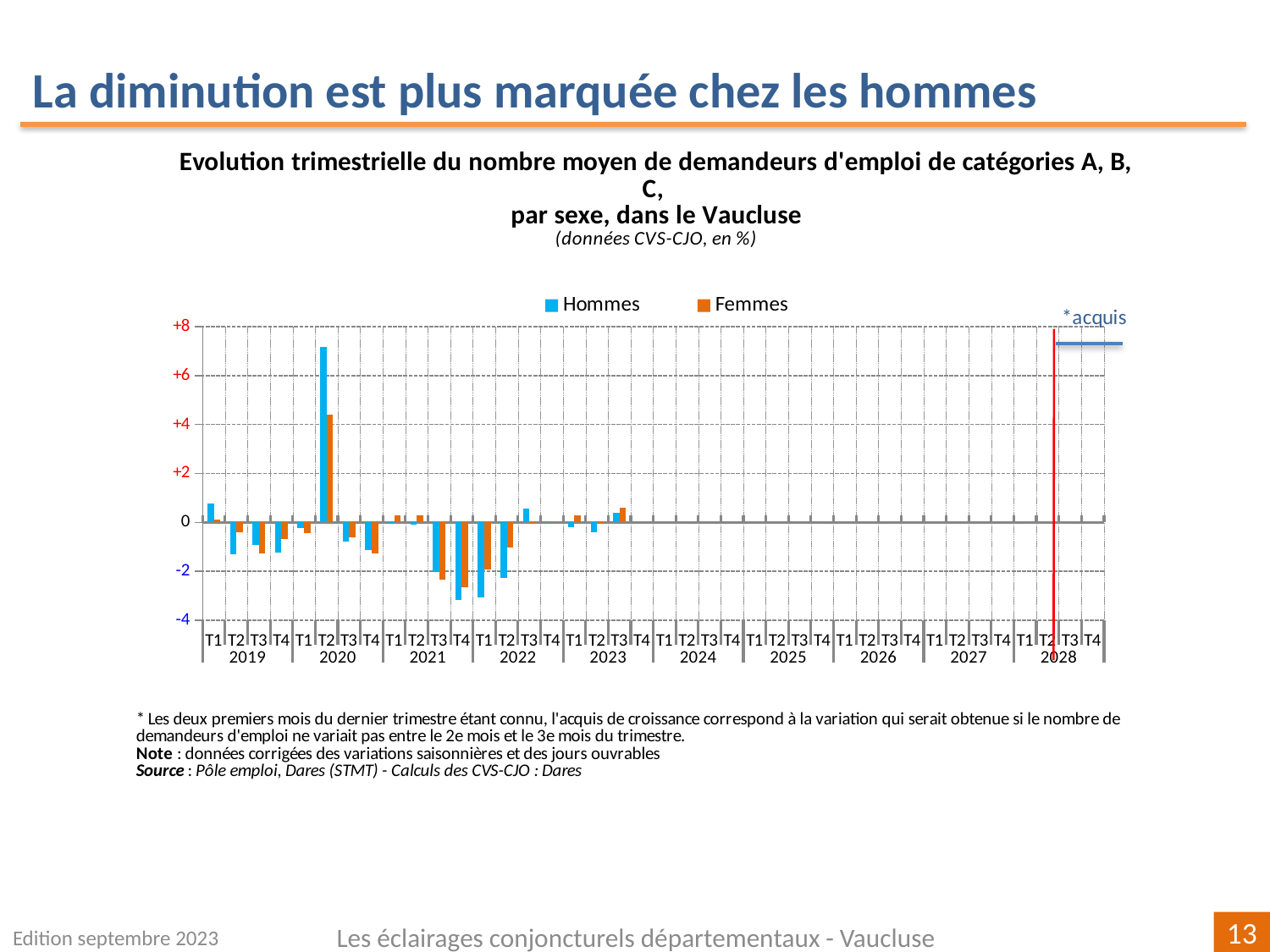
In which quarter does the Femmes series reach its highest value? T2 2020 How many years are labelled along the x axis? 10 Is the value for Hommes in T4 2021 greater or less than -2? less In which quarter does the Hommes series reach its highest value? T2 2020 In T1 2019, which series has the larger value, Hommes or Femmes? Hommes Is the value for Hommes in T2 2020 greater or less than +6? greater What are the two series named in the legend? Hommes and Femmes Which colour represents the Femmes series? orange How many series does the legend list? 2 In T2 2020, which series has the larger value, Hommes or Femmes? Hommes What kind of chart is shown on the slide? bar chart Is the value for Femmes in T2 2020 greater or less than +2? greater